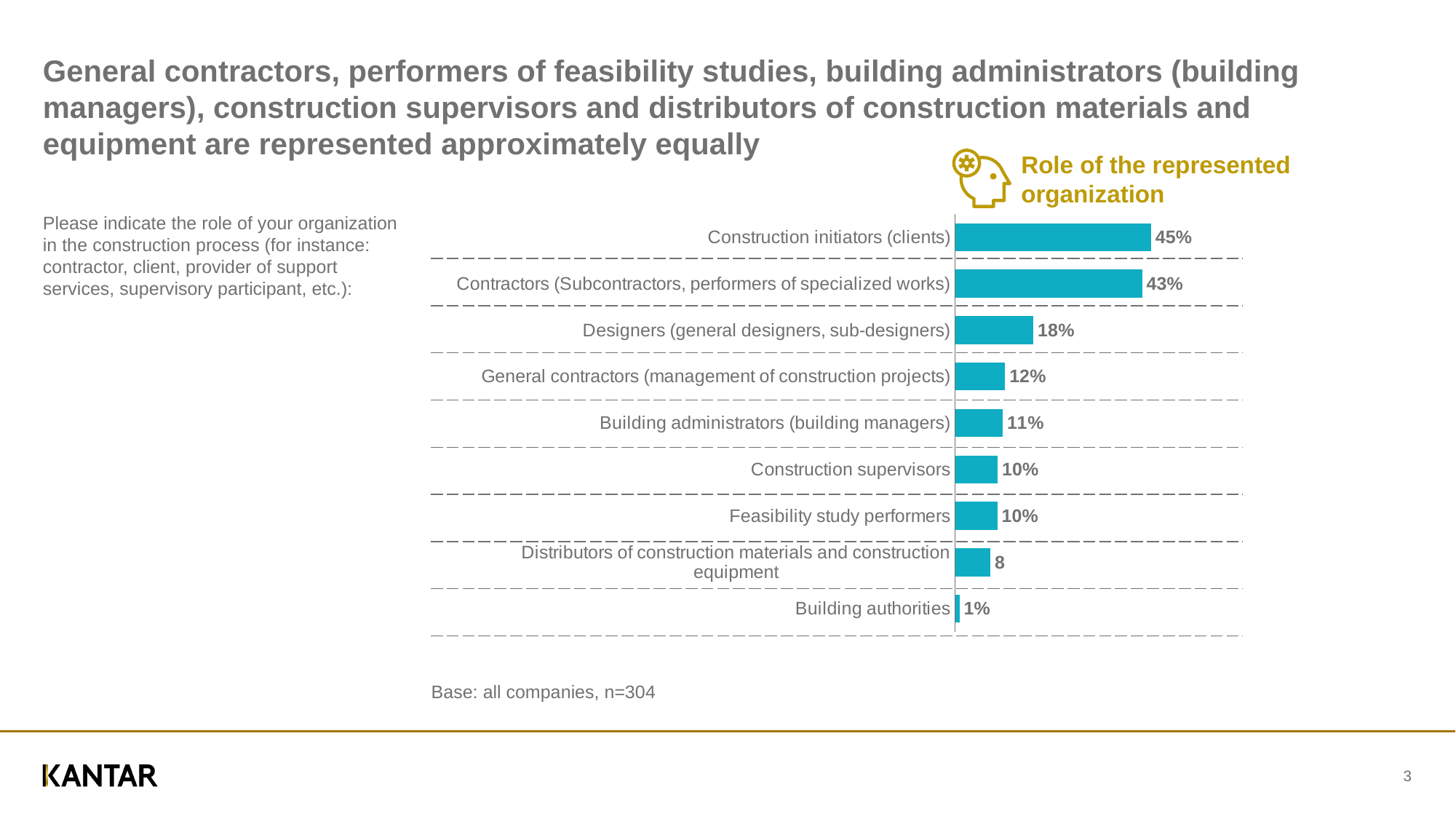
Which is larger: Designers (general designers, sub-designers) or Construction supervisors? Designers (general designers, sub-designers) Which category has the lowest value? Building authorities Which category has the highest value? Construction initiators (clients) What is the title of the chart? Role of the represented organization What is the value shown for Building administrators (building managers)? 11% What is the value shown for Designers (general designers, sub-designers)? 18% What kind of chart is shown on the slide? Bar chart How many categories are shown in the chart? 9 What percentage of organizations are Construction initiators (clients)? 45% What value is labelled for Distributors of construction materials and construction equipment? 8 What is the difference between Designers (general designers, sub-designers) and General contractors (management of construction projects)? 6% What is the difference between Construction initiators (clients) and Contractors (Subcontractors, performers of specialized works)? 2%